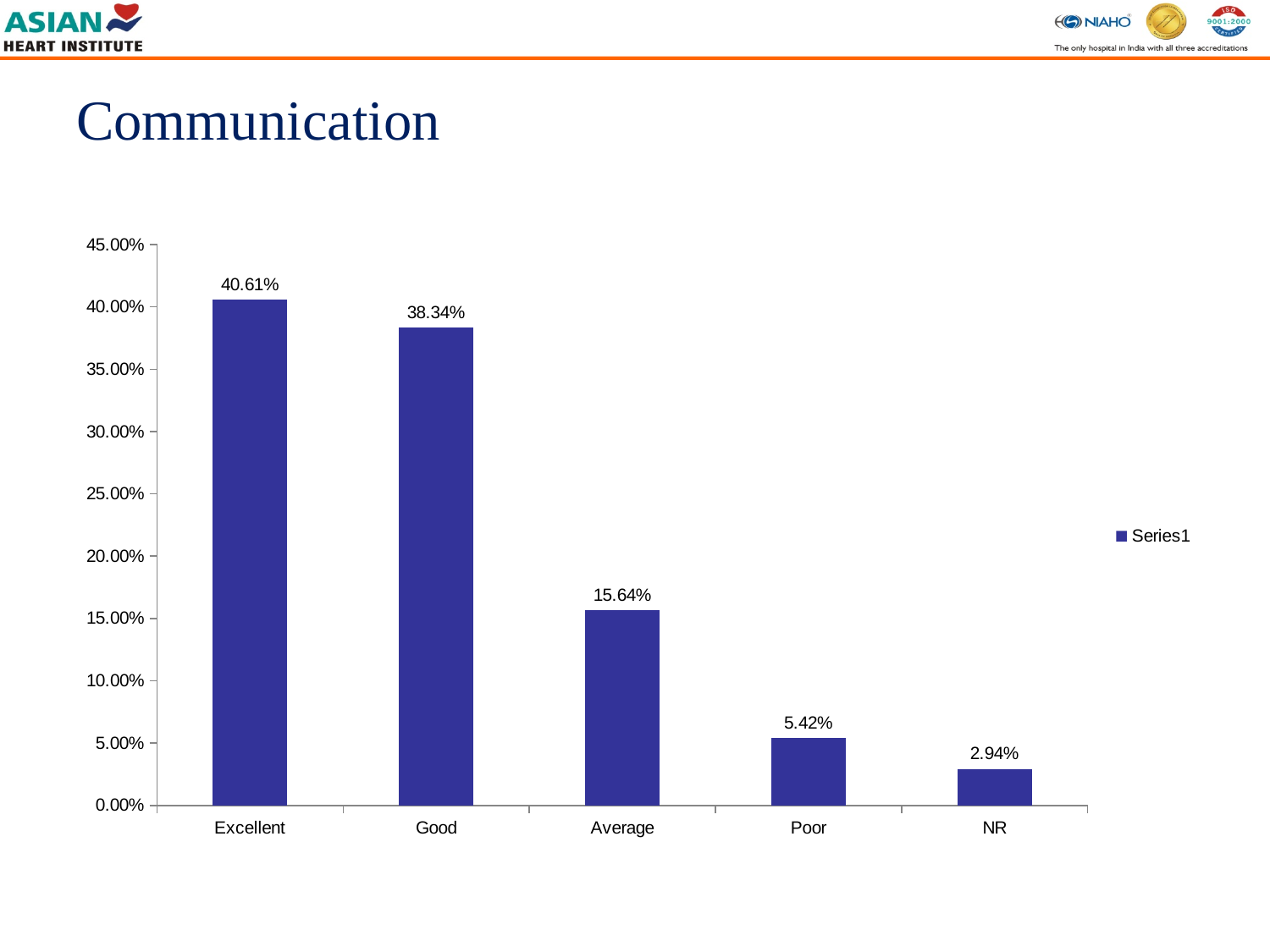
What is the value for Excellent? 40.61% What kind of chart is shown on the slide? Bar chart What is the title of the slide containing the chart? Communication Is the value for Good greater or less than 35.00%? greater Which category has the lowest value? NR Which is larger, the value for Average or the value for Poor? Average What is the difference between the values for Excellent and Good? 2.27% What is the difference between the values for Poor and NR? 2.48% Which category has the highest value? Excellent What is the value for NR? 2.94% How many categories are shown on the x axis? 5 What is the value for Average? 15.64%